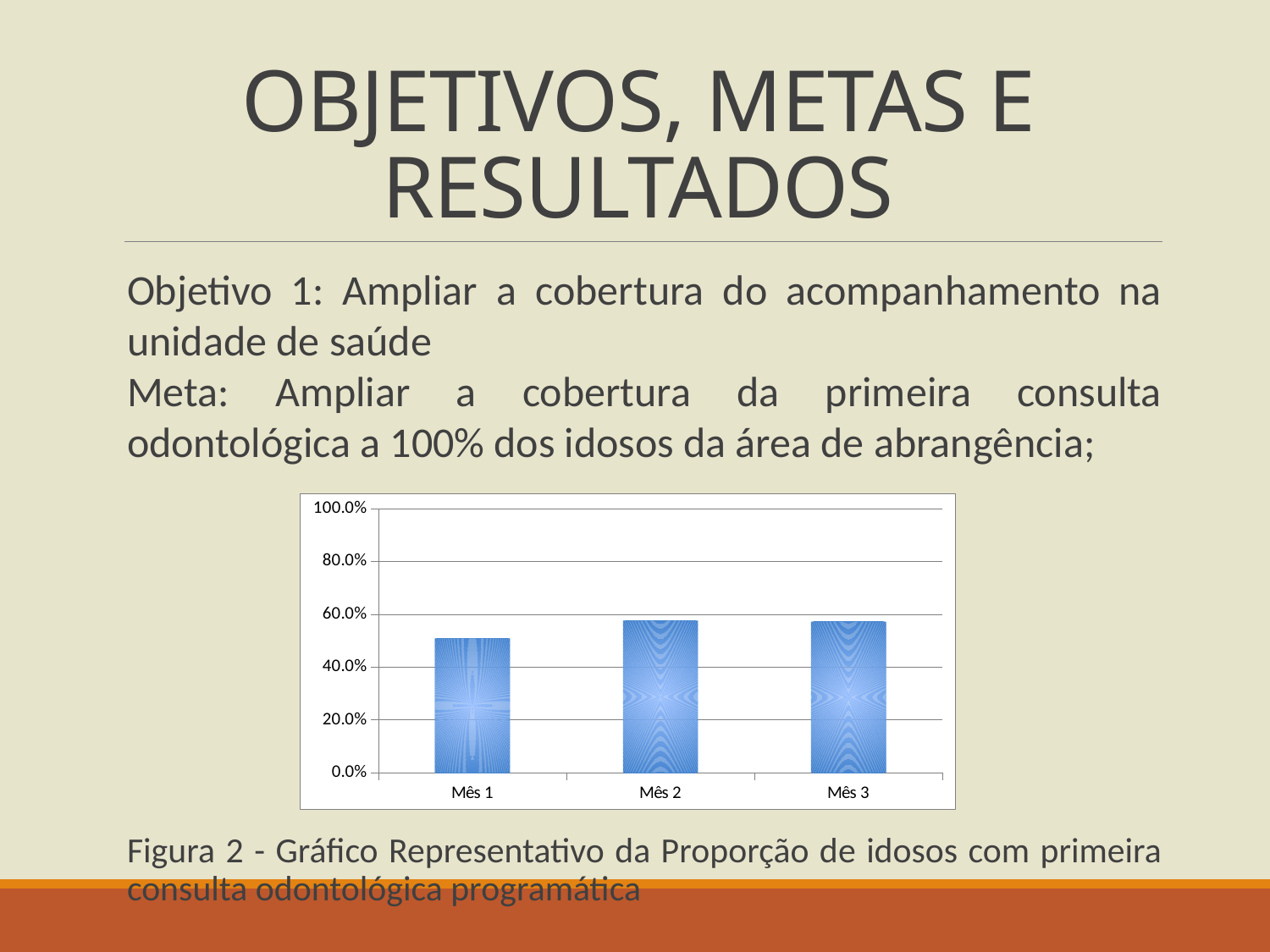
What are the category labels along the horizontal axis of the chart? Mês 1, Mês 2, Mês 3 Which is larger, the value for Mês 1 or the value for Mês 2? Mês 2 What kind of chart is shown on the slide? bar chart Is the value for Mês 3 greater or less than 40.0%? greater Is the value for Mês 1 greater or less than 40.0%? greater Is the value for Mês 2 greater or less than 60.0%? less How many categories (bars) does the chart show? 3 Which is larger, the value for Mês 1 or the value for Mês 3? Mês 3 What is the highest tick value shown on the vertical axis of the chart? 100.0% Which category has the lowest value in the chart? Mês 1